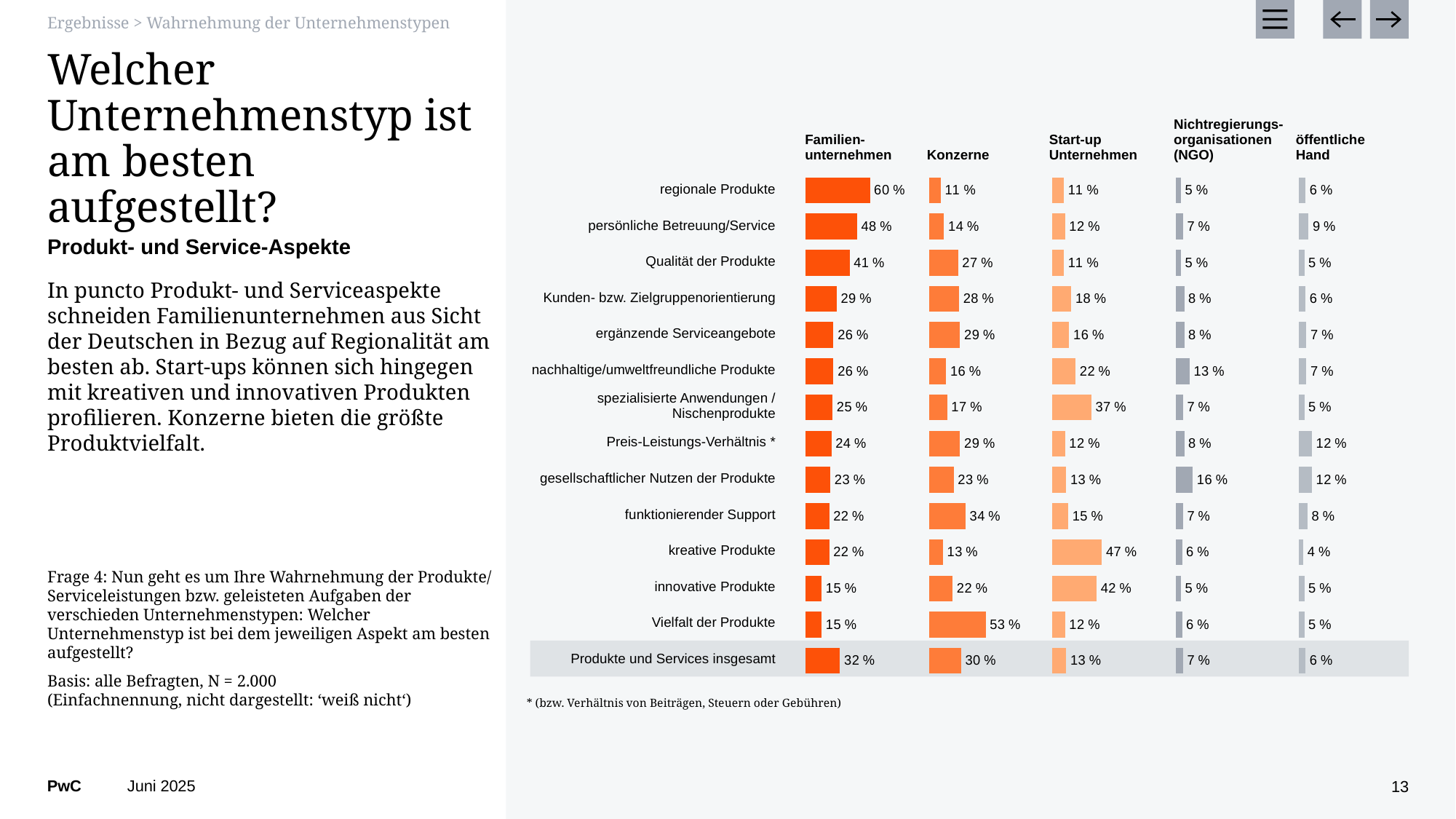
What is the value for Start-up Unternehmen for kreative Produkte? 47 % Which company type has the highest value for Produkte und Services insgesamt? Familienunternehmen How many company types (series) are shown in the chart? 5 What is the value for Nichtregierungsorganisationen (NGO) for gesellschaftlicher Nutzen der Produkte? 16 % Which company type has the lowest value for kreative Produkte? öffentliche Hand Which is larger for innovative Produkte: the value for Konzerne or the value for Start-up Unternehmen? Start-up Unternehmen How many product and service aspects (rows) are shown in the chart, including the overall row? 14 Which aspect has the highest value for Konzerne? Vielfalt der Produkte What is the value for Konzerne for Vielfalt der Produkte? 53 % What kind of chart is shown on the slide? Bar chart What percentage of respondents see Familienunternehmen as best positioned for regionale Produkte? 60 % What is the difference between Familienunternehmen and Konzerne for regionale Produkte? 49 percentage points